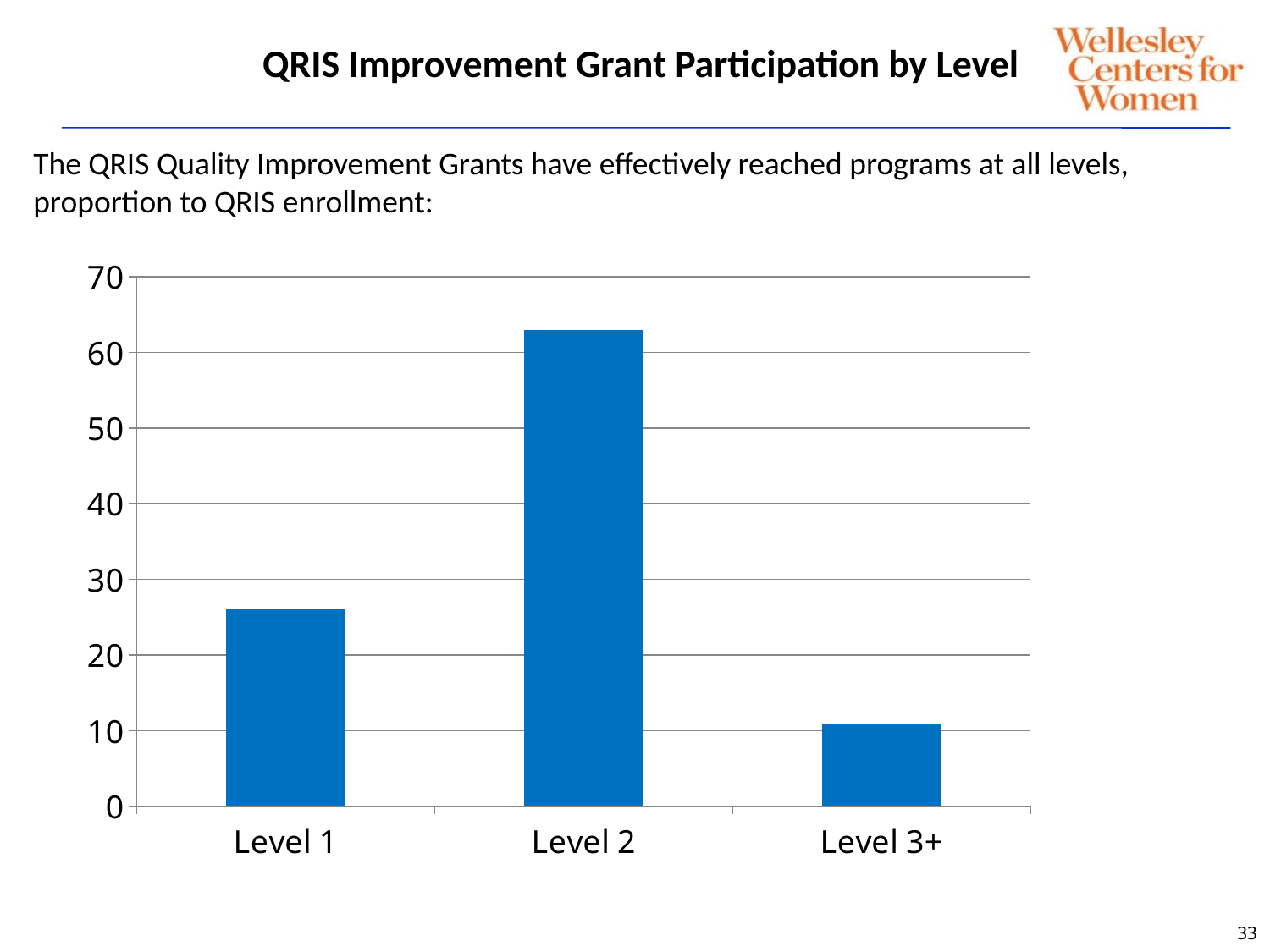
Which is larger, the value for Level 1 or the value for Level 3+? Level 1 What is the title of the slide containing the chart? QRIS Improvement Grant Participation by Level Which level has the highest bar in the chart? Level 2 Is the value for Level 3+ greater or less than 20? less Is the value for Level 1 greater or less than 20? greater Is the value for Level 1 greater or less than 30? less Which level has the lowest bar in the chart? Level 3+ Which is larger, the value for Level 2 or the value for Level 1? Level 2 What kind of chart is shown on the slide? bar chart How many categories are shown on the x axis of the chart? 3